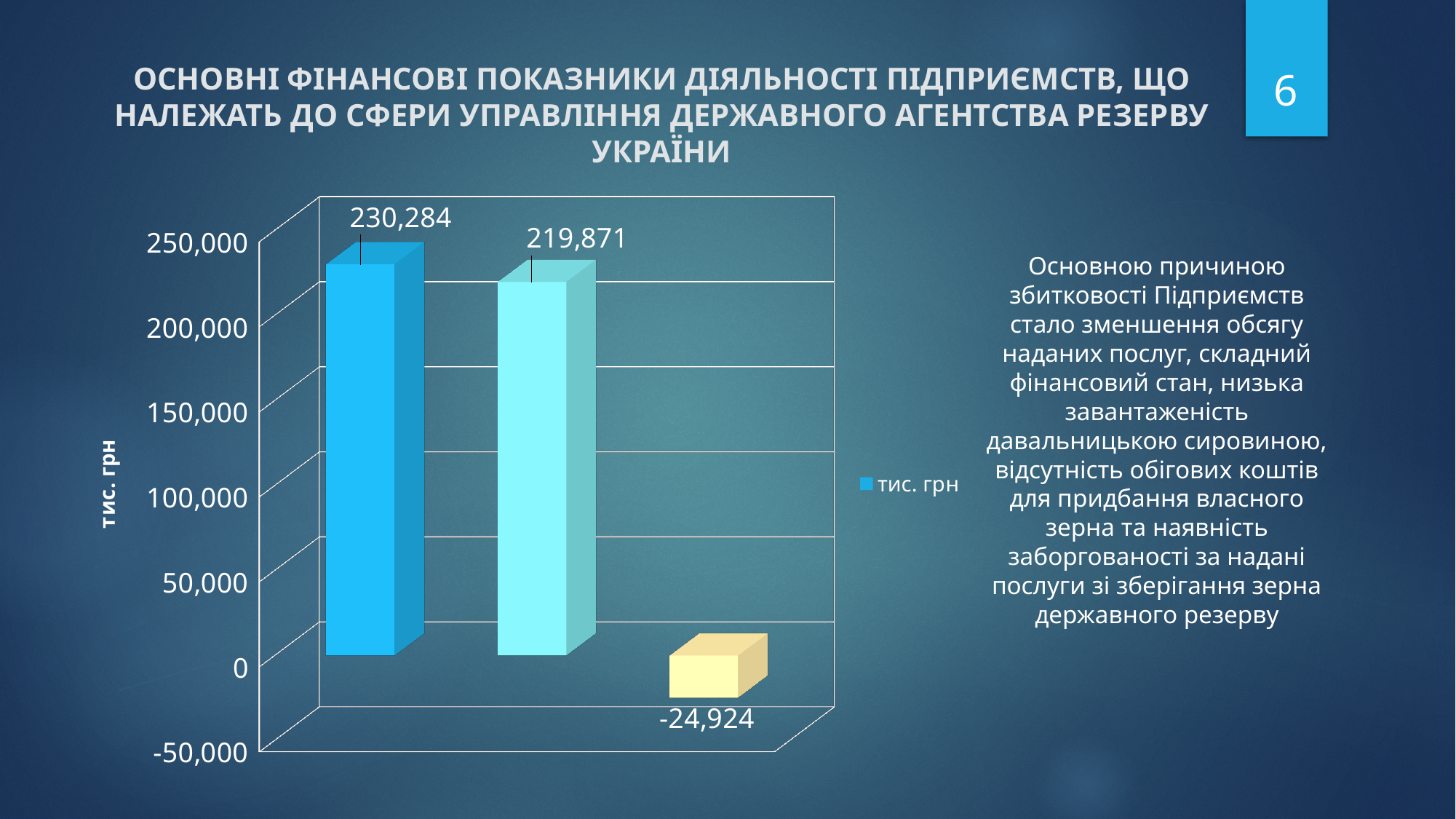
What is the value shown on the data label of the rightmost (yellow) bar? -24,924 What is the value shown on the data label of the leftmost (dark blue) bar? 230,284 Which is larger, the value of the middle bar or the value of the right bar? the middle bar What kind of chart is shown on the slide? bar chart What is the difference between the values of the left bar and the middle bar? 10,413 Which bar has the highest value: the left, middle or right one? the left one How many bars are plotted in the chart? 3 Which bar has the lowest value: the left, middle or right one? the right one What is the legend entry of the chart? тис. грн Is the value of the middle bar greater or less than 200,000? greater How many series does the legend list? 1 What is the value shown on the data label of the middle (light cyan) bar? 219,871